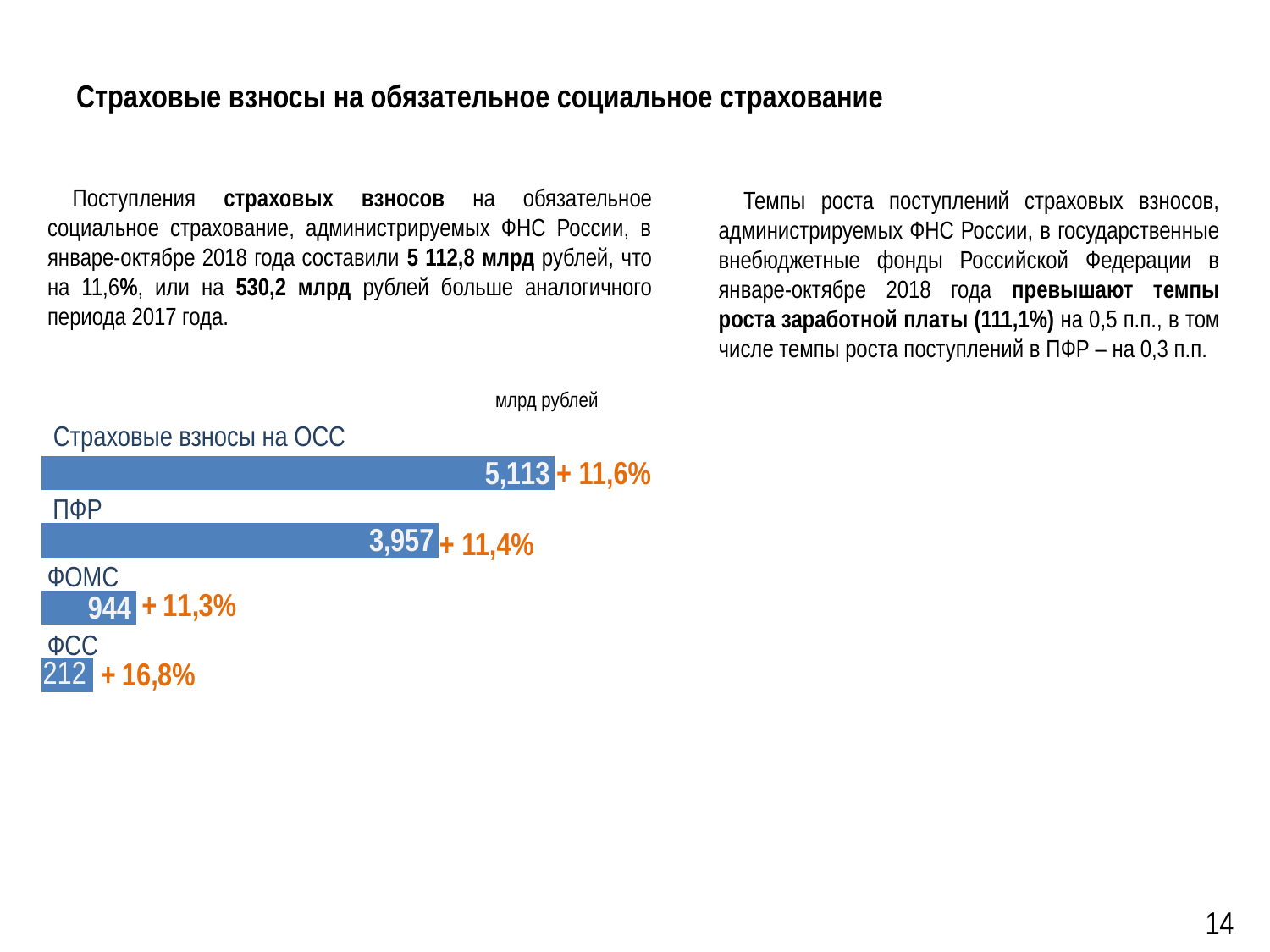
What is the difference between the values for ПФР and ФОМС? 3,013 What growth percentage is shown next to the ФСС bar? + 16,8% What is the value shown for ПФР in the bar chart? 3,957 How many categories are shown in the bar chart? 4 What type of chart is shown on the slide? Bar chart Which category has the highest value in the bar chart? Страховые взносы на ОСС What is the value shown for ФОМС in the bar chart? 944 What is the value shown for Страховые взносы на ОСС in the bar chart? 5,113 What growth percentage is shown next to the ПФР bar? + 11,4% What is the value shown for ФСС in the bar chart? 212 Which is larger, the value for ФОМС or the value for ФСС? ФОМС Which category has the lowest value in the bar chart? ФСС